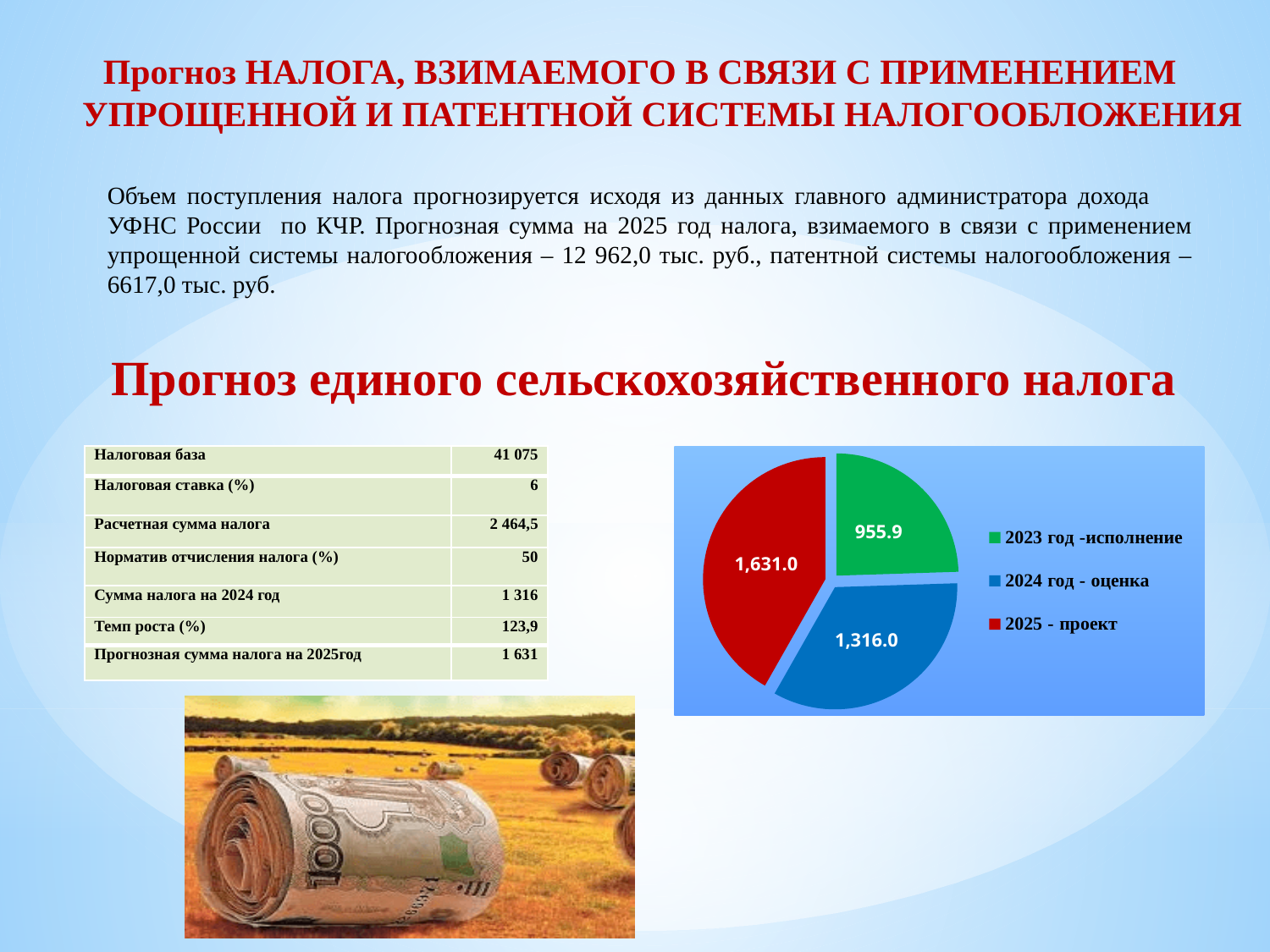
Which slice of the pie chart has the smallest value? 2023 год - исполнение What is the value for 2025 - проект in the pie chart? 1,631.0 How many slices does the pie chart have? 3 What is the value for 2024 год - оценка in the pie chart? 1,316.0 What is the difference between the values for 2025 - проект and 2024 год - оценка in the pie chart? 315.0 What type of chart is shown on the slide? pie chart What is the value for 2023 год - исполнение in the pie chart? 955.9 Which is larger in the pie chart: the value for 2024 год - оценка or for 2023 год - исполнение? 2024 год - оценка Which slice of the pie chart has the largest value? 2025 - проект How many entries does the legend of the pie chart list? 3 What is the difference between the values for 2024 год - оценка and 2023 год - исполнение in the pie chart? 360.1 What colour is the slice for 2025 - проект in the pie chart? red